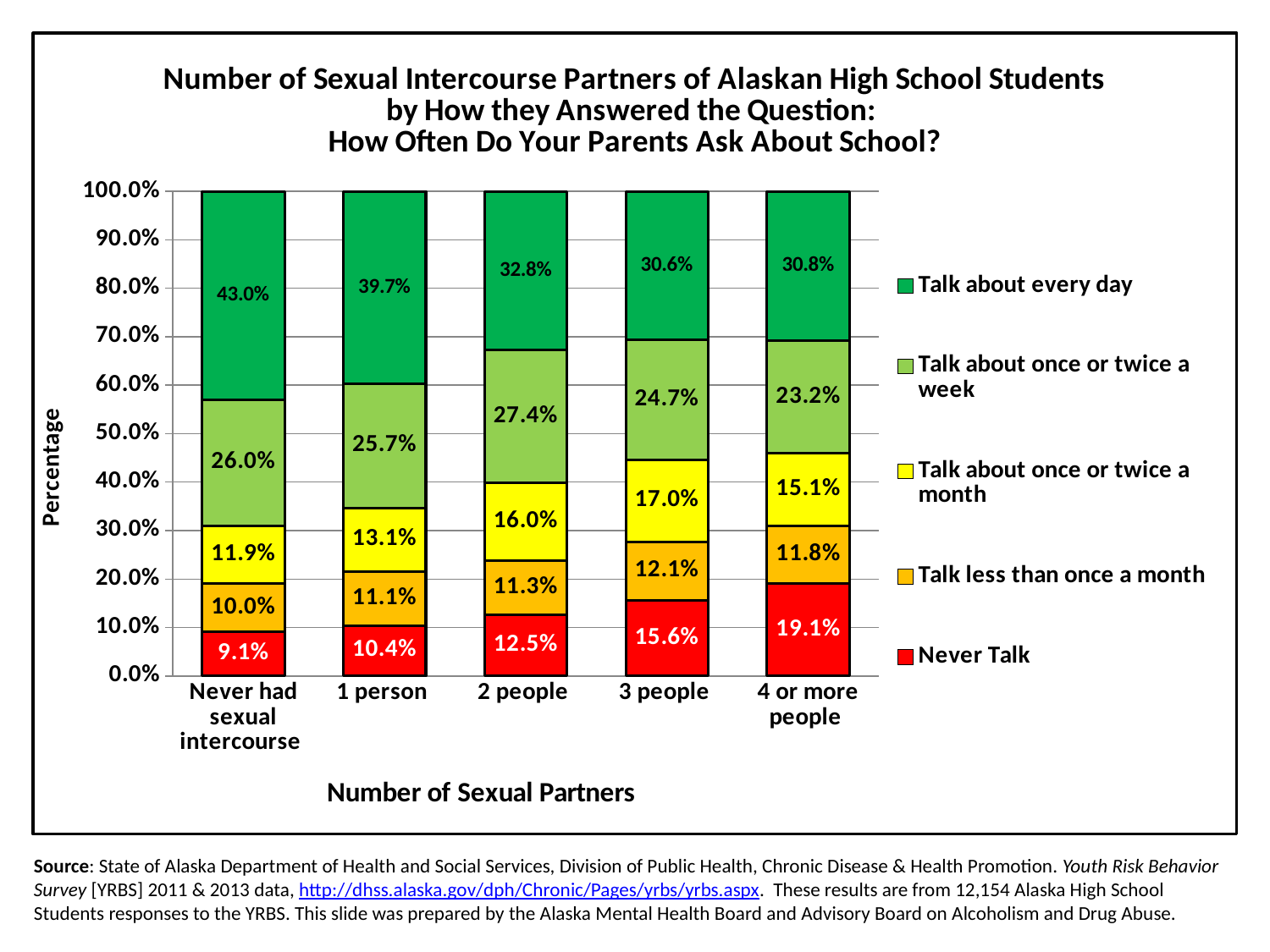
What is the difference between the 'Never Talk' values for 4 or more people and for never had sexual intercourse? 10.0 percentage points What is the 'Talk about once or twice a month' value for the 2 people category? 16.0% Does the 'Never Talk' percentage rise or fall as the number of sexual partners increases along the x axis? Rise What is the 'Never Talk' value for students with 4 or more people as sexual partners? 19.1% Which number-of-partners category has the lowest 'Talk about every day' percentage? 3 people What percentage of students who never had sexual intercourse said their parents talk about school every day? 43.0% How many number-of-partners categories are shown on the x axis? 5 Which is larger: the 'Talk about once or twice a week' value for 2 people or for 3 people? 2 people What kind of chart is shown on the slide? Stacked bar chart What colour represents the 'Never Talk' series in the chart? Red Which number-of-partners category has the highest 'Never Talk' percentage? 4 or more people How many series does the legend list? 5